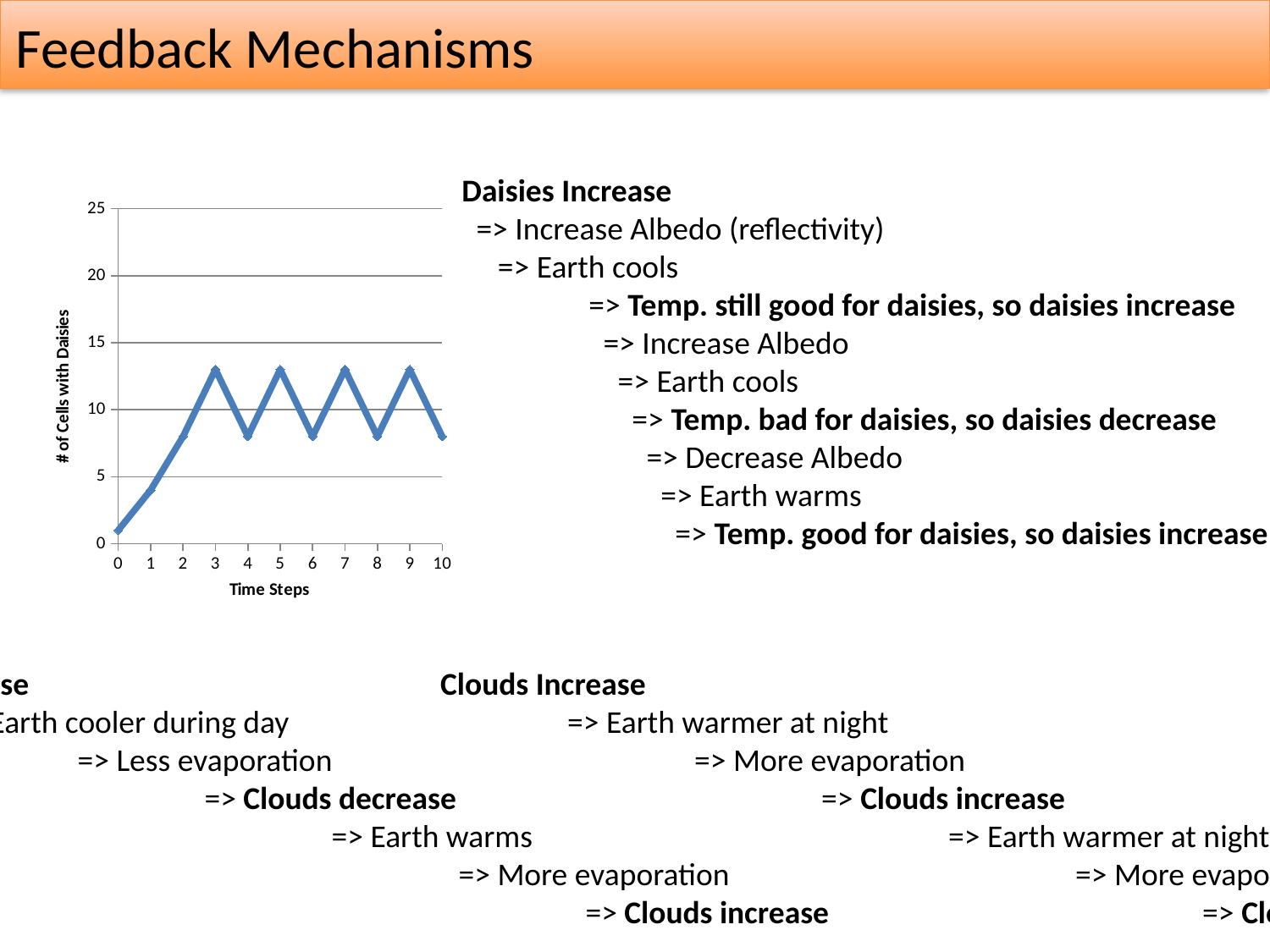
Is the value for time step 3 greater or less than 15? less Is the value for time step 3 greater or less than 10? greater Which time step has the lowest number of cells with daisies? 0 How many time steps are plotted on the chart? 11 What is the title of the x axis of the chart? Time Steps Do the values rise or fall from time step 0 to time step 3? rise What kind of chart is shown on the slide? line chart Which is larger, the value at time step 3 or the value at time step 4? time step 3 Is the value for time step 0 greater or less than 5? less What is the title of the y axis of the chart? # of Cells with Daisies